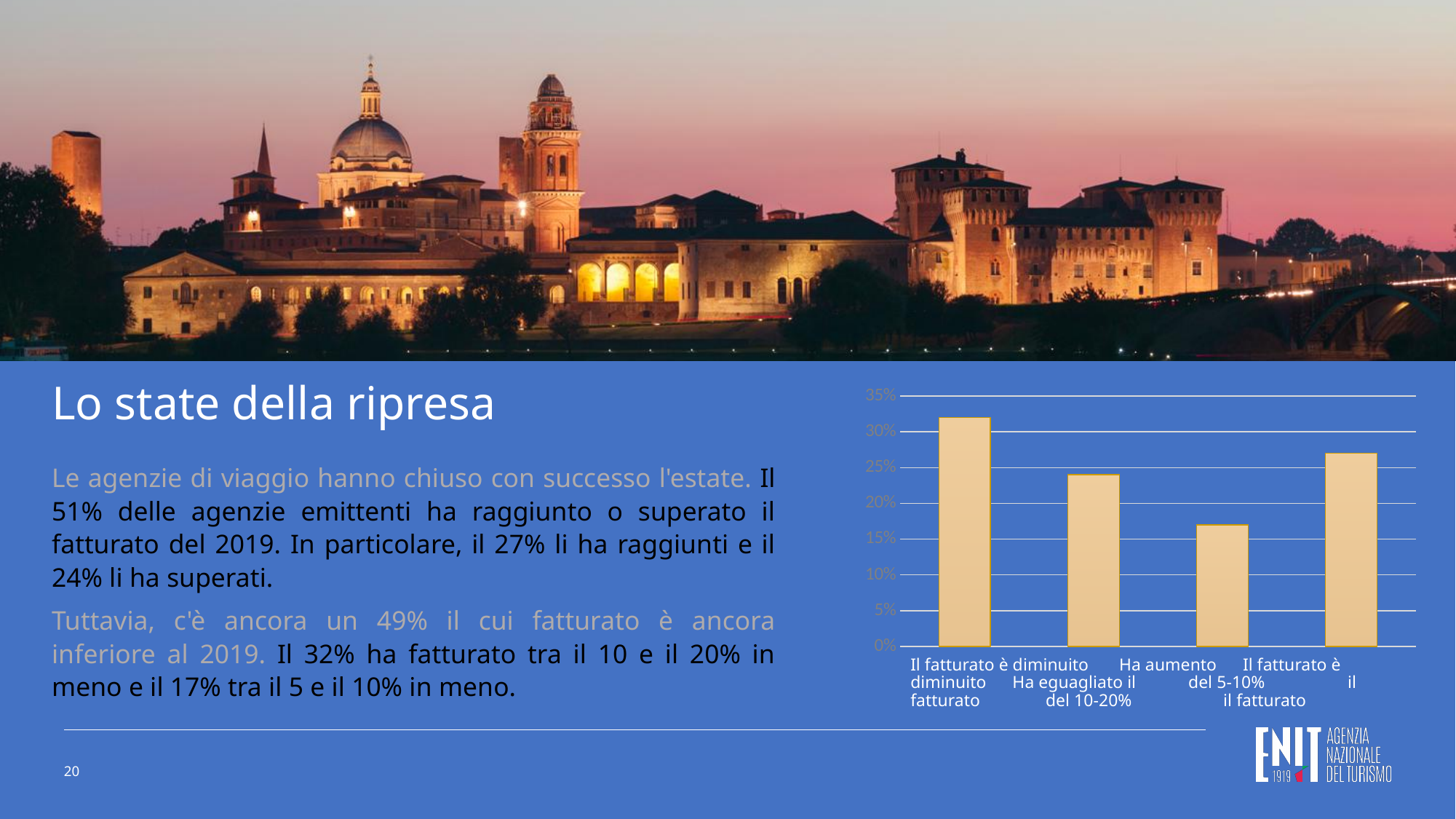
Is the value of the second bar greater or less than 25%? less How many bars does the chart show? 4 What kind of chart is shown on the slide? bar chart Is the value of the fourth (rightmost) bar greater or less than 25%? greater Which bar in the chart is the tallest? the first (leftmost) bar Which bar in the chart is the shortest? the third bar What is the highest value shown on the chart's vertical axis? 35% Is the value of the first (leftmost) bar greater or less than 30%? greater Which is larger, the second bar or the fourth bar? the fourth bar